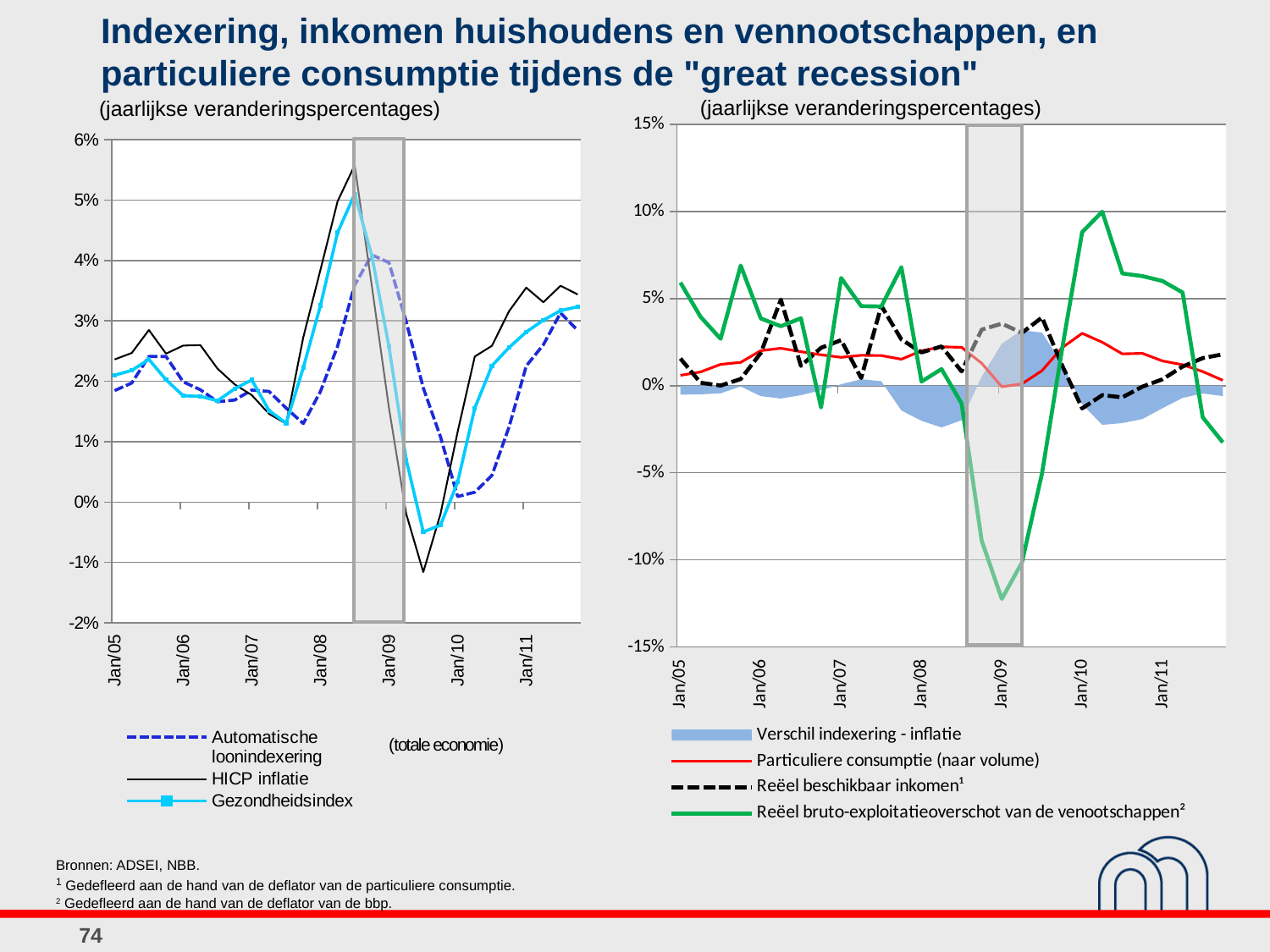
In the right chart, which series is drawn as a green line? Reëel bruto-exploitatieoverschot van de venootschappen How many year labels are shown on the x axis of the right chart? 7 In the left chart, which series is drawn as a dashed blue line? Automatische loonindexering In the left chart, is the lowest value of HICP inflatie in 2009 greater or less than 0%? less What kind of chart is the left chart? line chart In the left chart, does HICP inflatie rise or fall between Jan/08 and Jan/09? fall How many series does the legend of the right chart list? 4 How many series does the legend of the left chart list? 3 In the left chart, does Gezondheidsindex rise or fall between Jan/10 and Jan/11? rise In the left chart, is the peak value of HICP inflatie in 2008 greater or less than 5%? greater In the right chart, is the lowest value of Reëel bruto-exploitatieoverschot van de venootschappen around Jan/09 greater or less than -10%? less